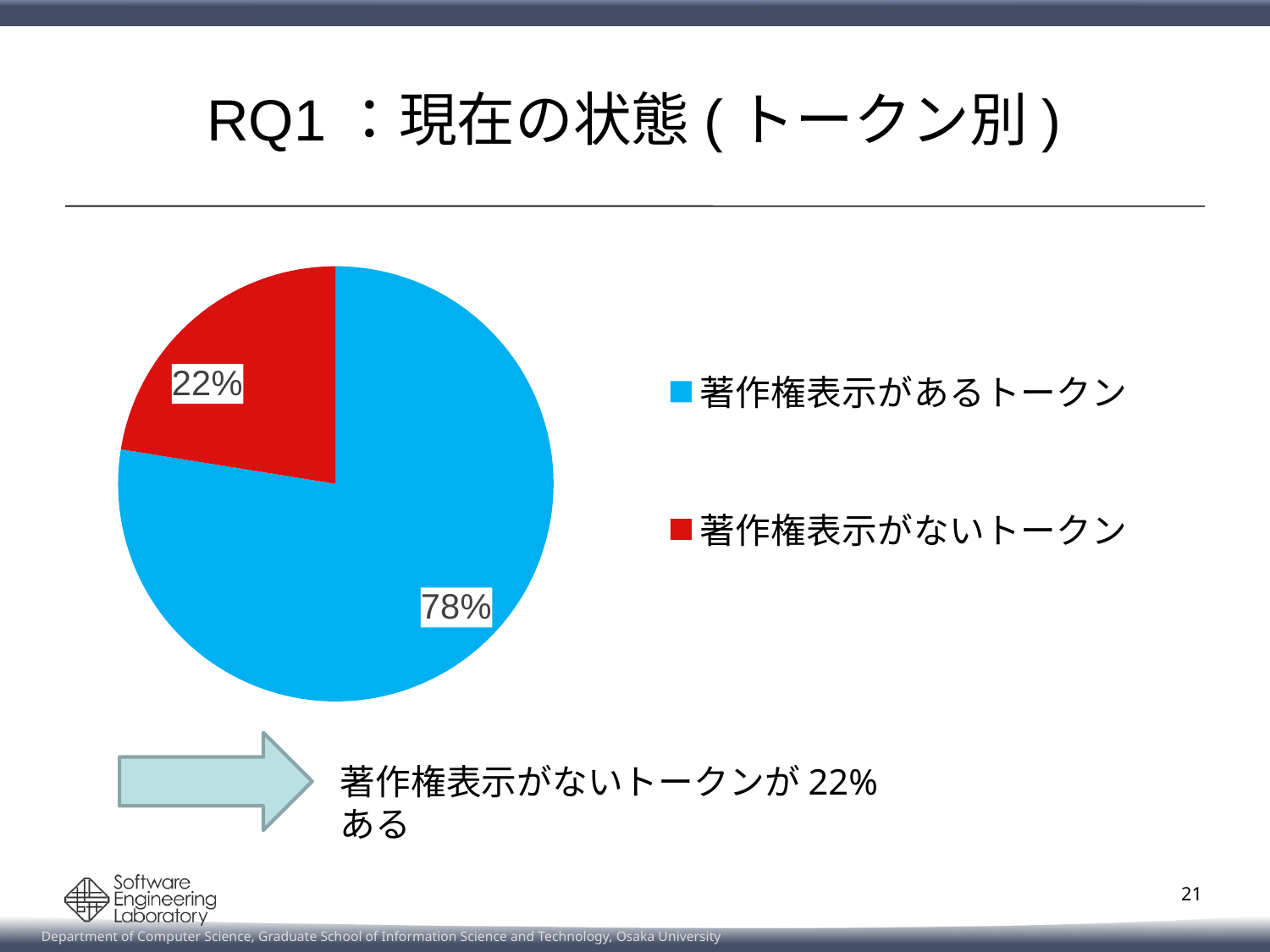
What is the difference in percentage points between the 著作権表示があるトークン slice and the 著作権表示がないトークン slice? 56 What colour is the slice for 著作権表示がないトークン? red Which category has the largest slice of the pie? 著作権表示があるトークン What share of the pie does 著作権表示がないトークン take? 22% What kind of chart is shown on the slide? pie chart How many slices does the pie chart have? 2 Which is larger, the slice for 著作権表示があるトークン or the slice for 著作権表示がないトークン? 著作権表示があるトークン What colour is the slice for 著作権表示があるトークン? blue How many entries does the legend list? 2 Which category has the smallest slice of the pie? 著作権表示がないトークン What share of the pie does 著作権表示があるトークン take? 78%